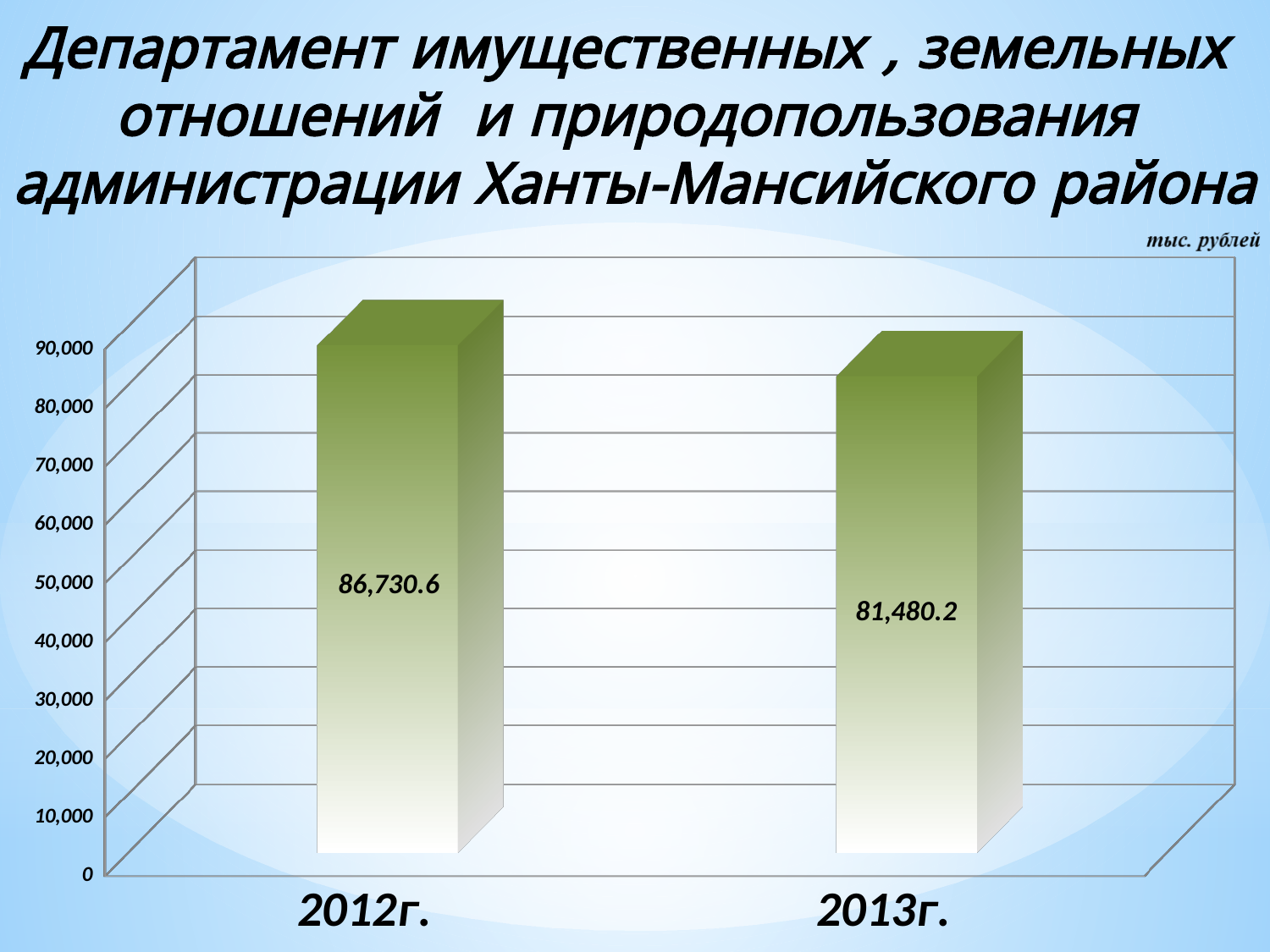
Is the value for 2013г. larger or smaller than the value for 2012г.? smaller Which year has the lower value? 2013г. Which year has the higher value? 2012г. How many bars are plotted in the chart? 2 What is the difference between the 2012г. and 2013г. values? 5,250.4 What unit is indicated above the chart? тыс. рублей What type of chart is shown on the slide? bar chart Do the values rise or fall from 2012г. to 2013г.? fall What is the value shown for 2012г.? 86,730.6 Is the value for 2013г. greater or less than 80,000? greater Is the value for 2012г. greater or less than 90,000? less What is the value shown for 2013г.? 81,480.2